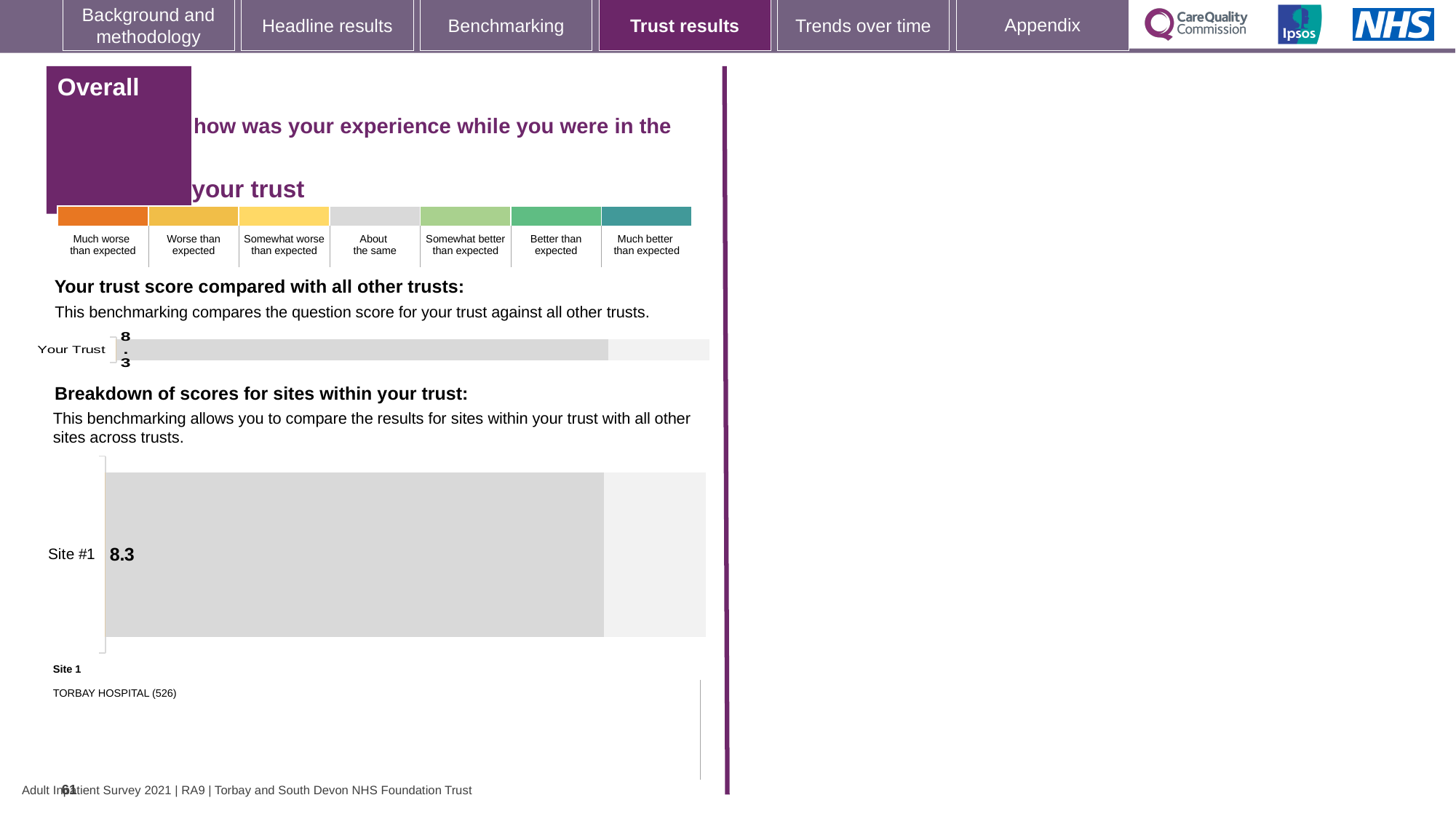
What kind of chart is the 'Your trust score compared with all other trusts' chart? Bar chart What is the difference between the Your Trust score in the top chart and the Site #1 score in the bottom chart? 0 In the 'Your trust score compared with all other trusts' chart, is the Your Trust score greater or less than 5? greater How many categories are shown in the 'Your trust score compared with all other trusts' chart? 1 How many bars are plotted in the 'Breakdown of scores for sites within your trust' chart? 1 In the 'Breakdown of scores for sites within your trust' chart, what is the score for Site #1? 8.3 In the 'Your trust score compared with all other trusts' chart, what is the score for Your Trust? 8.3 What kind of chart is the 'Breakdown of scores for sites within your trust' chart? Bar chart In the 'Breakdown of scores for sites within your trust' chart, which hospital is Site 1? TORBAY HOSPITAL (526)